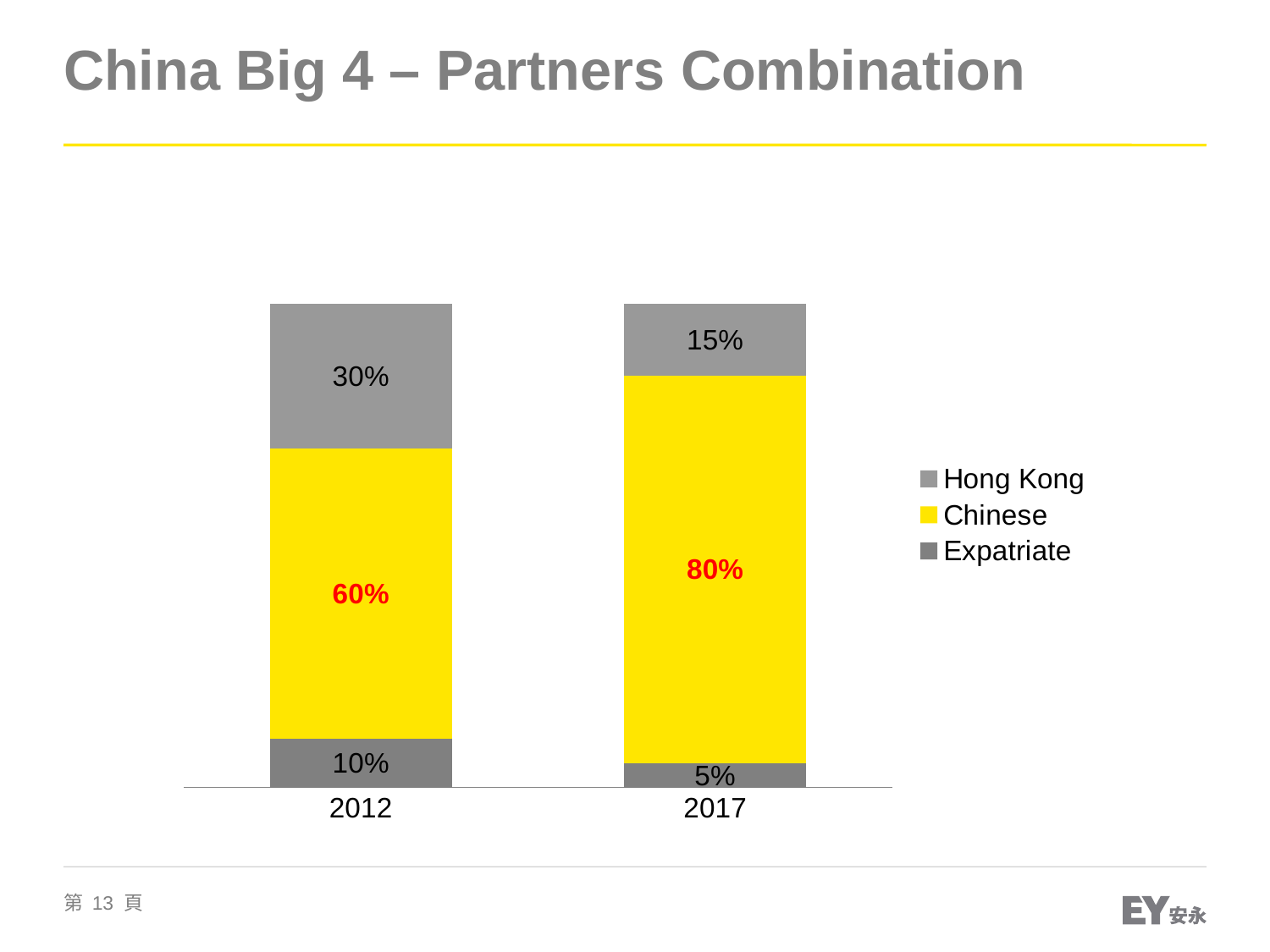
Which year has the higher Hong Kong share of partners? 2012 What is the Expatriate share of partners in 2017? 5% Which series has the largest share in 2017? Chinese What is the Hong Kong share of partners in 2012? 30% What is the difference between the Hong Kong share in 2012 and in 2017? 15% What kind of chart is shown on the slide? Stacked bar chart How many series does the legend list? 3 Which series has the smallest share in 2012? Expatriate By how many percentage points did the Chinese share increase from 2012 to 2017? 20% What is the Chinese share of partners in 2012? 60% What is the Chinese share of partners in 2017? 80% How many years are shown on the x axis? 2